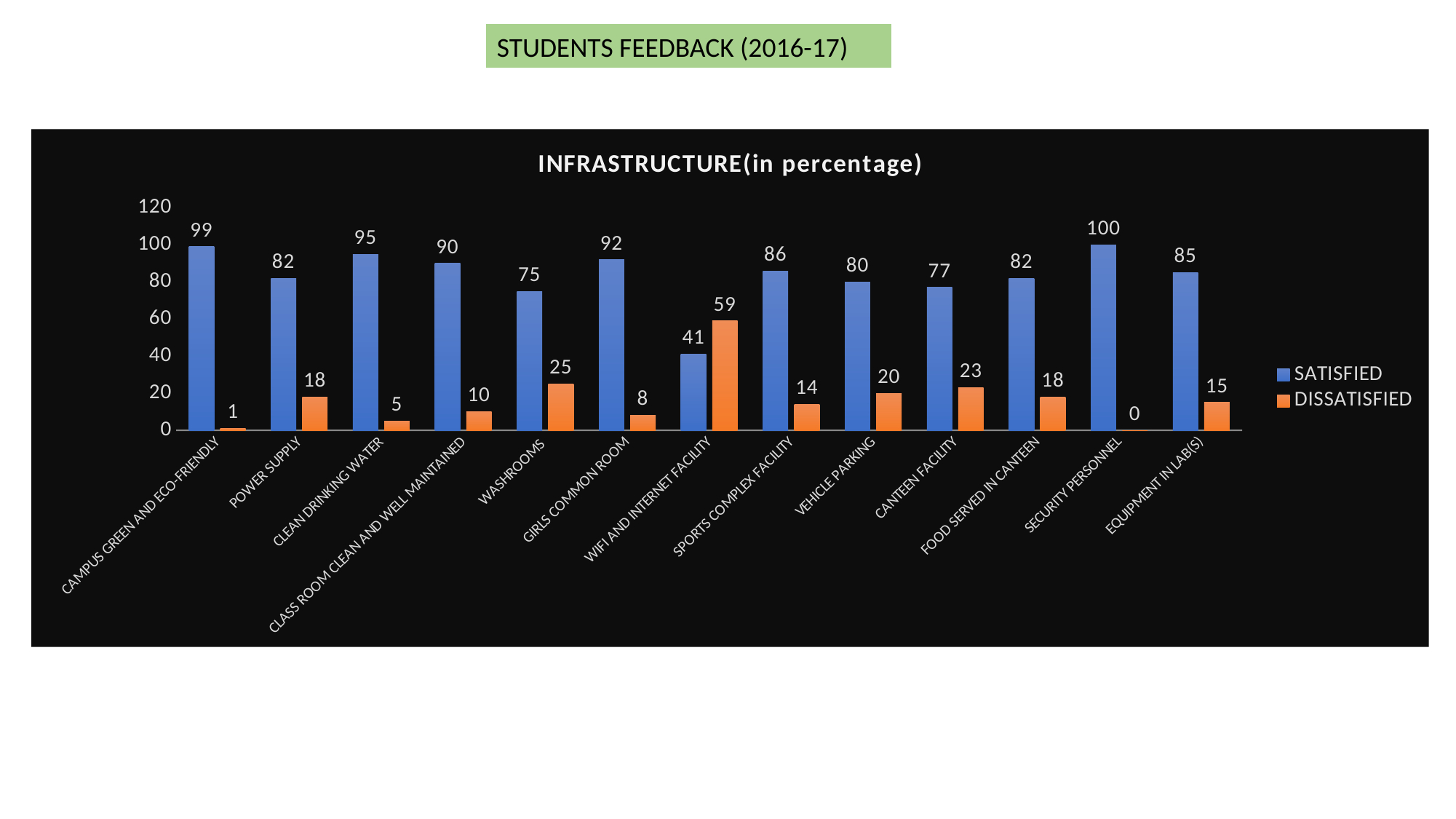
What is the title of the chart? INFRASTRUCTURE(in percentage) Which category has the lowest SATISFIED value? WIFI AND INTERNET FACILITY Which category has the highest SATISFIED value? SECURITY PERSONNEL How many series does the legend list? 2 What is the SATISFIED value for WASHROOMS? 75 What is the DISSATISFIED value for WIFI AND INTERNET FACILITY? 59 Which is larger: the SATISFIED value for POWER SUPPLY or the SATISFIED value for VEHICLE PARKING? POWER SUPPLY What is the difference between the SATISFIED and DISSATISFIED values for CANTEEN FACILITY? 54 Which category has the highest DISSATISFIED value? WIFI AND INTERNET FACILITY How many categories are shown on the x axis? 13 What is the SATISFIED value for SECURITY PERSONNEL? 100 What kind of chart is shown? Bar chart